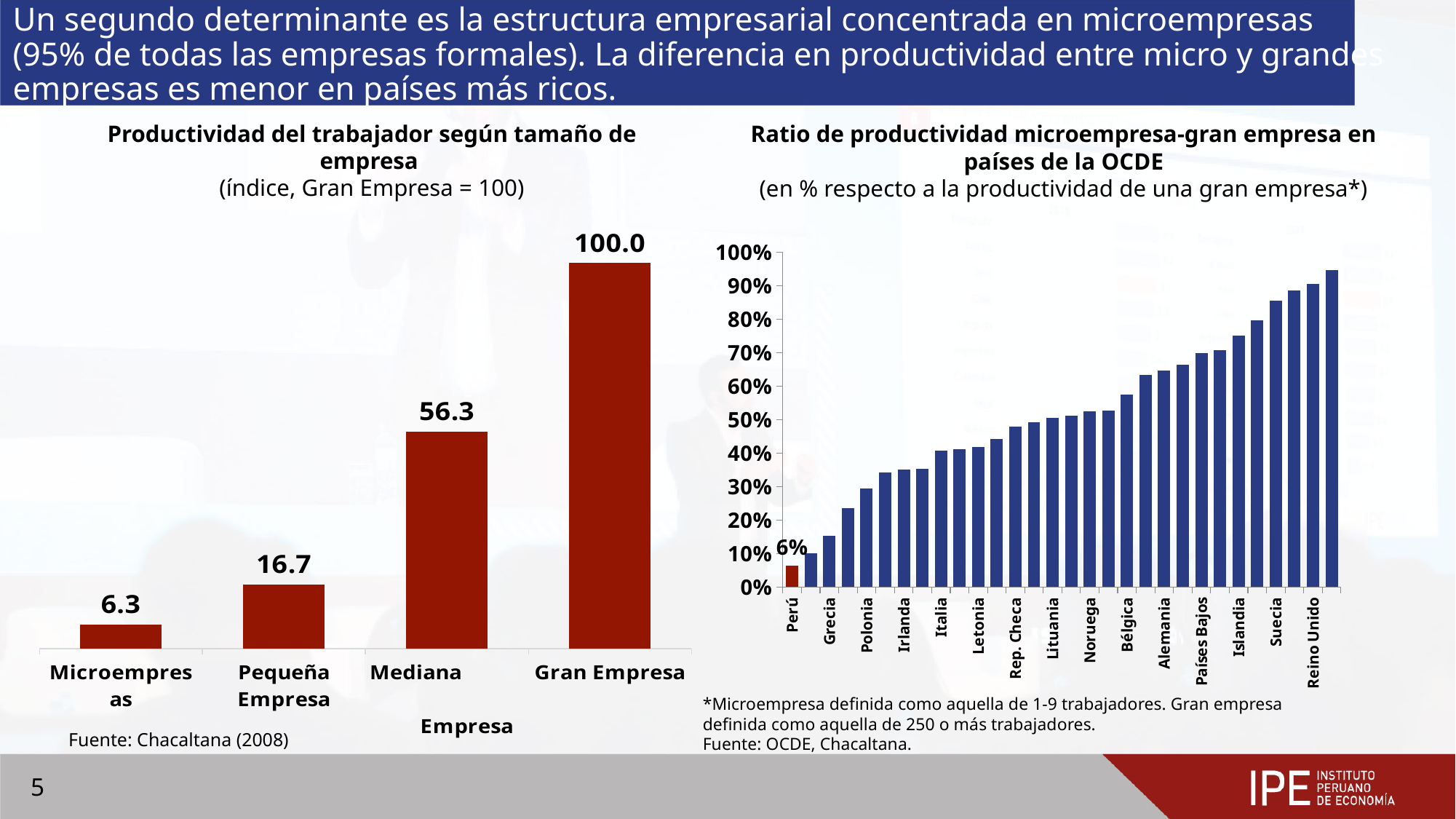
In the chart 'Productividad del trabajador según tamaño de empresa', what is the value for Mediana? 56.3 In the chart 'Productividad del trabajador según tamaño de empresa', what is the difference between Gran Empresa and Mediana? 43.7 In the chart 'Productividad del trabajador según tamaño de empresa', which category has the lowest value? Microempresas In the chart 'Ratio de productividad microempresa-gran empresa en países de la OCDE', what is the value for Perú? 6% In the chart 'Productividad del trabajador según tamaño de empresa', what is the difference between Pequeña Empresa and Microempresas? 10.4 What type of chart is 'Productividad del trabajador según tamaño de empresa'? Bar chart In the chart 'Productividad del trabajador según tamaño de empresa', what is the value for Pequeña Empresa? 16.7 In the chart 'Productividad del trabajador según tamaño de empresa', how many categories are shown? 4 In the chart 'Productividad del trabajador según tamaño de empresa', which category has the highest value? Gran Empresa In the chart 'Productividad del trabajador según tamaño de empresa', what is the value for Microempresas? 6.3 In the chart 'Ratio de productividad microempresa-gran empresa en países de la OCDE', do the values rise or fall from left to right? Rise